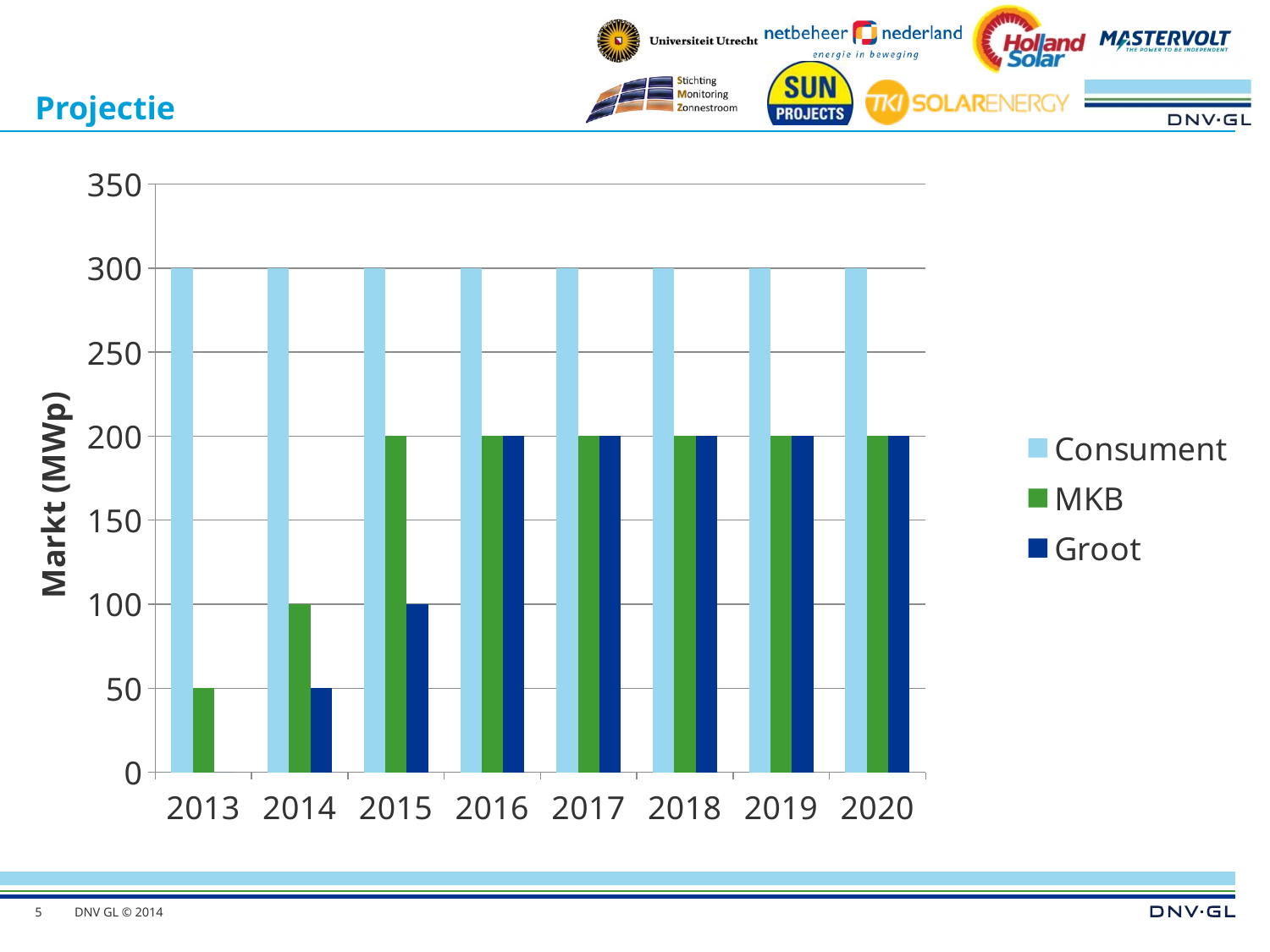
What is the value for Consument in 2013? 300 What kind of chart is shown on the slide? bar chart Does the MKB value rise or fall from 2013 to 2016? rise Which series has the lowest value in 2014? Groot What is the difference between the Consument and MKB values in 2015? 100 How many series does the legend list? 3 What is the value for MKB in 2014? 100 How many years are shown on the x axis? 8 Which series has the highest value in 2014? Consument What is the value for Groot in 2015? 100 What is the value for MKB in 2013? 50 What is the value for Groot in 2020? 200